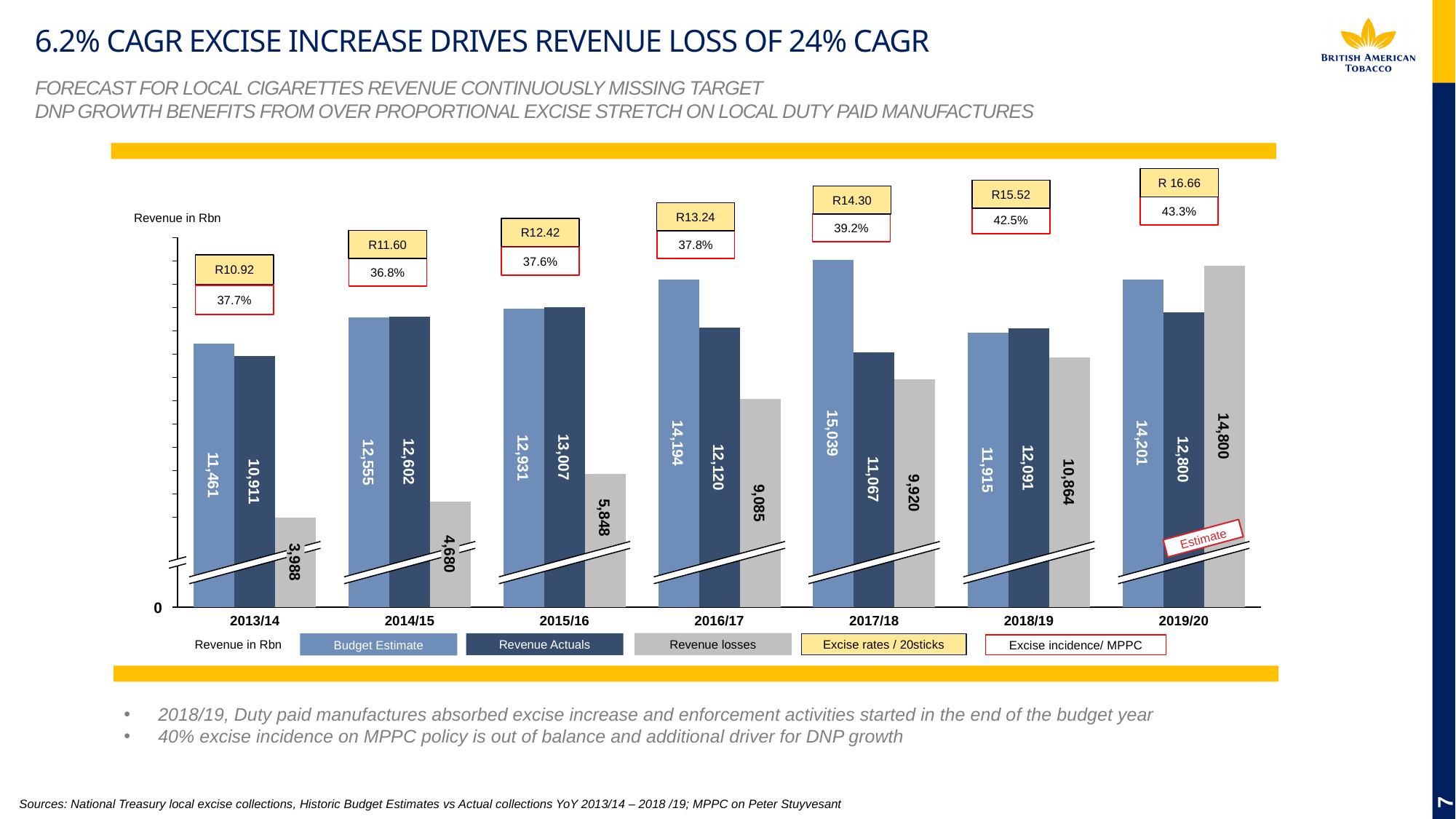
What is the difference between the Budget Estimate and Revenue Actuals in 2017/18? 3,972 What is the Revenue Actuals value for 2017/18? 11,067 Do the Revenue losses rise or fall from 2013/14 to 2019/20? Rise What is the Budget Estimate value for 2016/17? 14,194 In which year are Revenue losses lowest? 2013/14 What kind of chart is this? Bar chart In which year is the Budget Estimate highest? 2017/18 What is the Revenue losses value for 2015/16? 5,848 What is the excise rate per 20 sticks shown for 2018/19? R15.52 In 2014/15, which is larger: the Budget Estimate or Revenue Actuals? Revenue Actuals How many years are shown on the x axis? 7 What is the excise incidence / MPPC shown for 2014/15? 36.8%